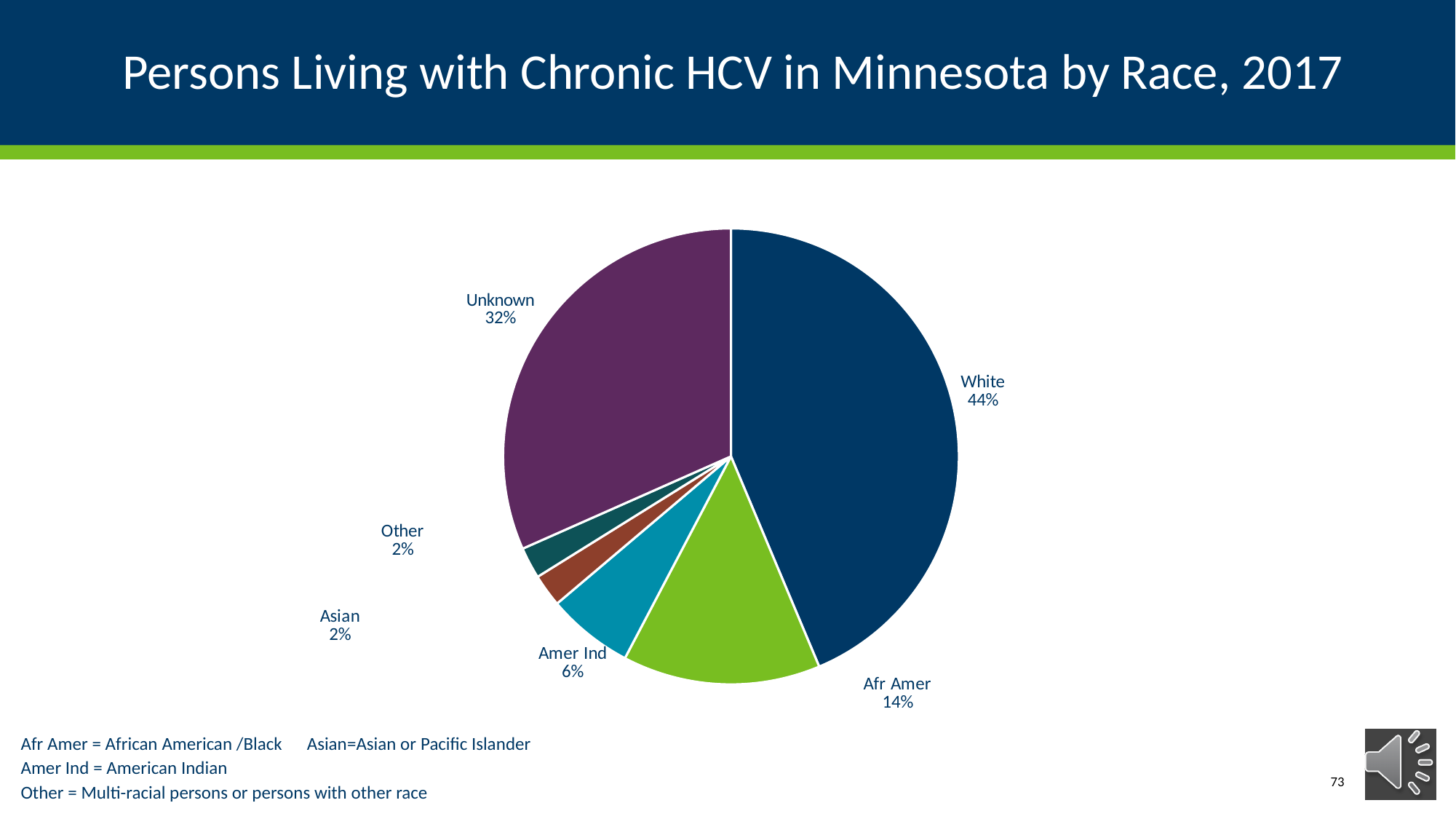
What is the title of the chart on the slide? Persons Living with Chronic HCV in Minnesota by Race, 2017 What share of persons living with chronic HCV in Minnesota in 2017 were White? 44% What percentage of the pie is labelled Unknown? 32% Which race category has the largest slice of the pie? White Which slice is larger, Afr Amer or Amer Ind? Afr Amer What is the difference in percentage points between the White and Unknown slices? 12 What share is shown for Afr Amer? 14% What percentage is shown for Amer Ind? 6% How many slices does the pie chart have? 6 What is the combined share of the Asian and Other slices? 4% According to the footnote, what does Amer Ind stand for? American Indian What kind of chart is shown on the slide? Pie chart